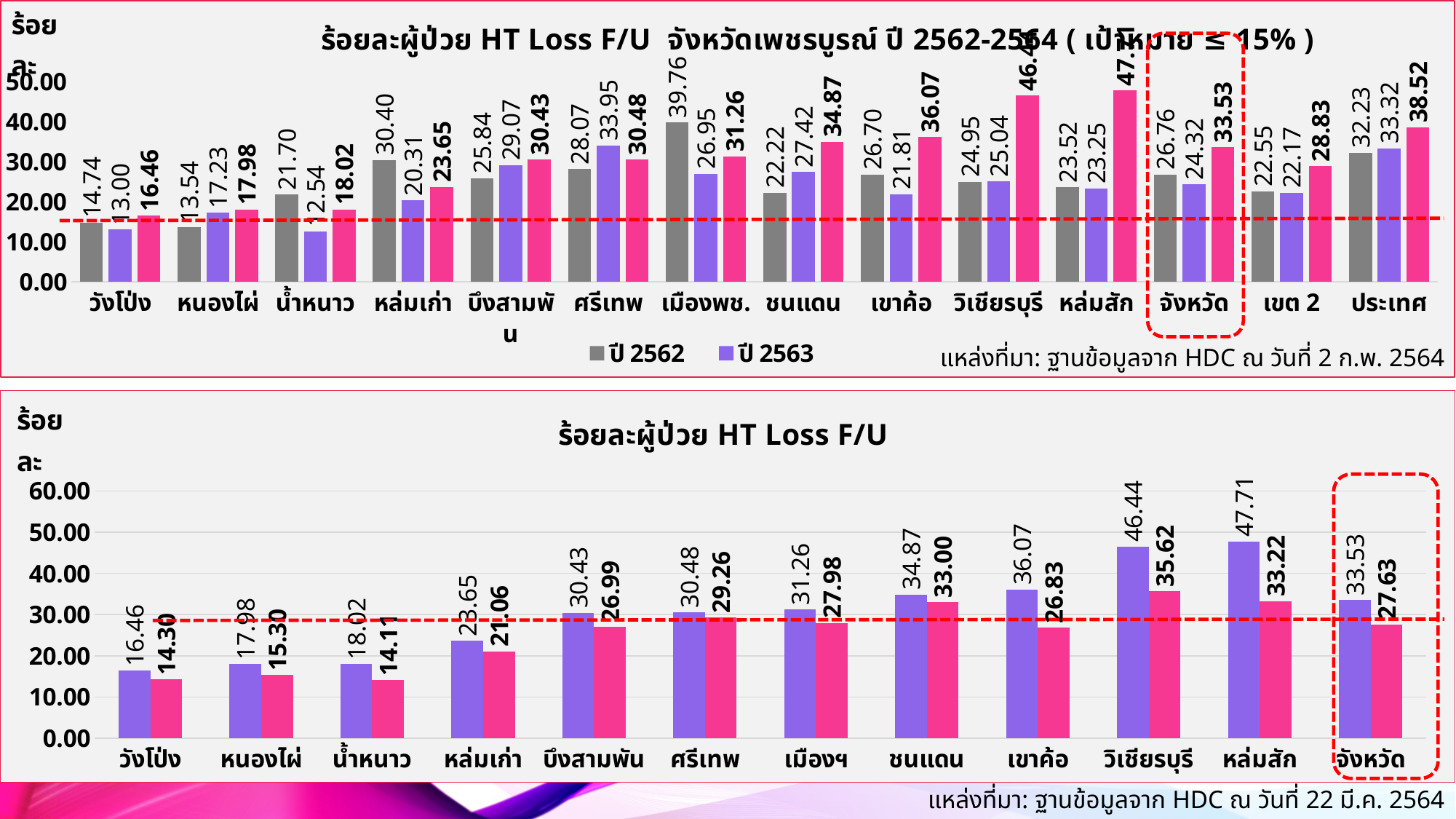
In the bottom chart, what is the value of the pink bar for วิเชียรบุรี? 35.62 In the top chart, what is the ปี 2562 value for เมืองพช.? 39.76 In the top chart, how many categories are shown on the x axis? 14 In the top chart, which category has the lowest ปี 2563 value? น้ำหนาว In the top chart, what is the value of the pink bar for ประเทศ? 38.52 In the top chart, which category has the highest ปี 2562 value? เมืองพช. In the bottom chart, is the purple bar or the pink bar larger for จังหวัด? purple bar In the bottom chart, which category has the highest purple bar? หล่มสัก In the top chart, what is the difference between the ปี 2562 and ปี 2563 values for หล่มเก่า? 10.09 In the top chart, what is the ปี 2563 value for ศรีเทพ? 33.95 In the bottom chart, which category has the lowest pink bar? น้ำหนาว What kind of chart is the bottom chart? bar chart